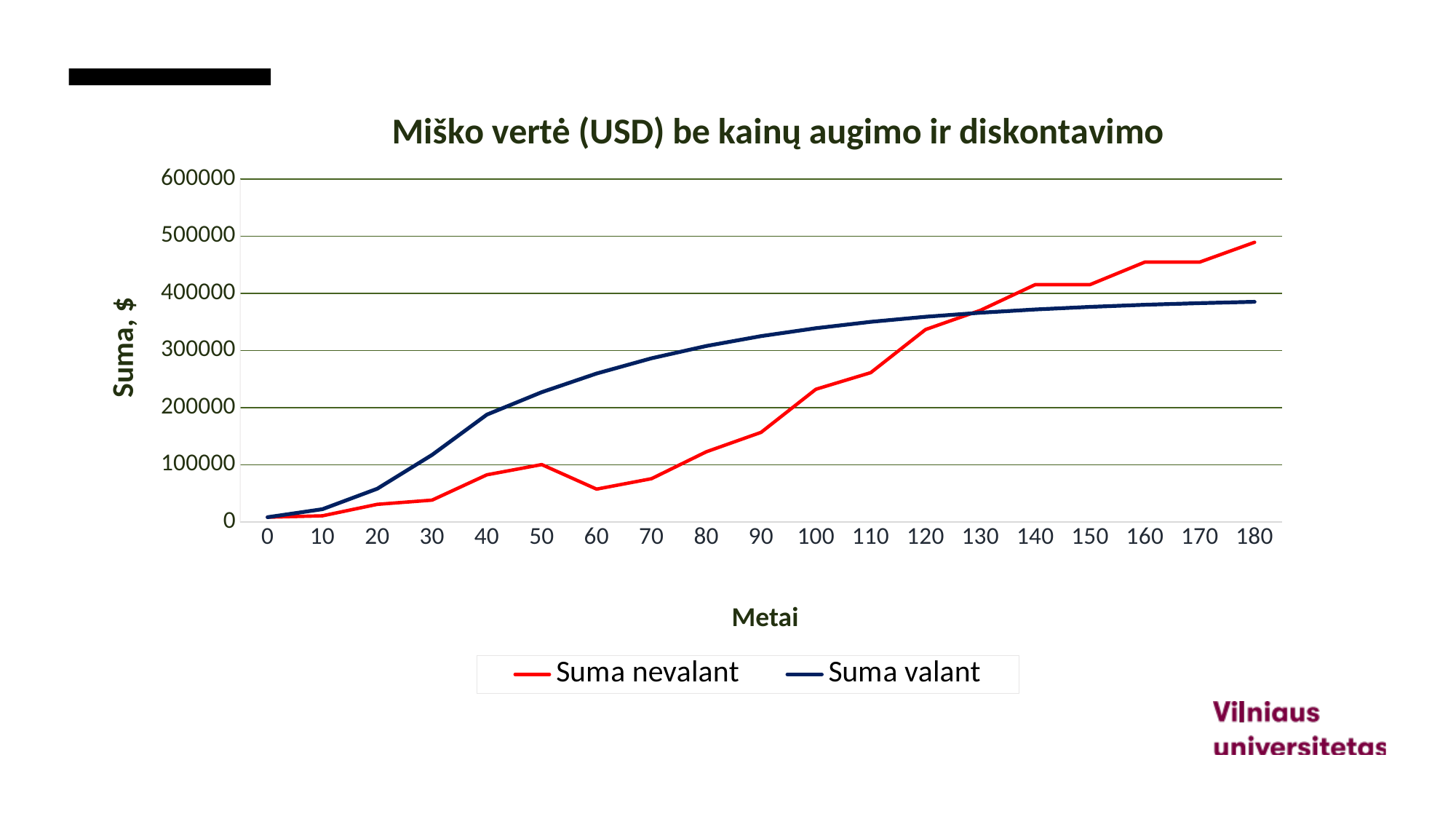
How many series does the legend list? 2 What kind of chart is shown on the slide? line chart How many points are marked along the x axis (Metai)? 19 Is the value of Suma valant at 40 years greater or less than 100000? greater At which year does the Suma nevalant series reach its highest value? 180 Does the Suma valant series rise or fall as the years increase along the x axis? rise Is the value of Suma nevalant at 60 years greater or less than 100000? less At 180 years, which series has the larger value, Suma nevalant or Suma valant? Suma nevalant At 100 years, which series has the larger value, Suma nevalant or Suma valant? Suma valant What is the title of the chart? Miško vertė (USD) be kainų augimo ir diskontavimo Is the value of Suma valant at 180 years greater or less than 400000? less